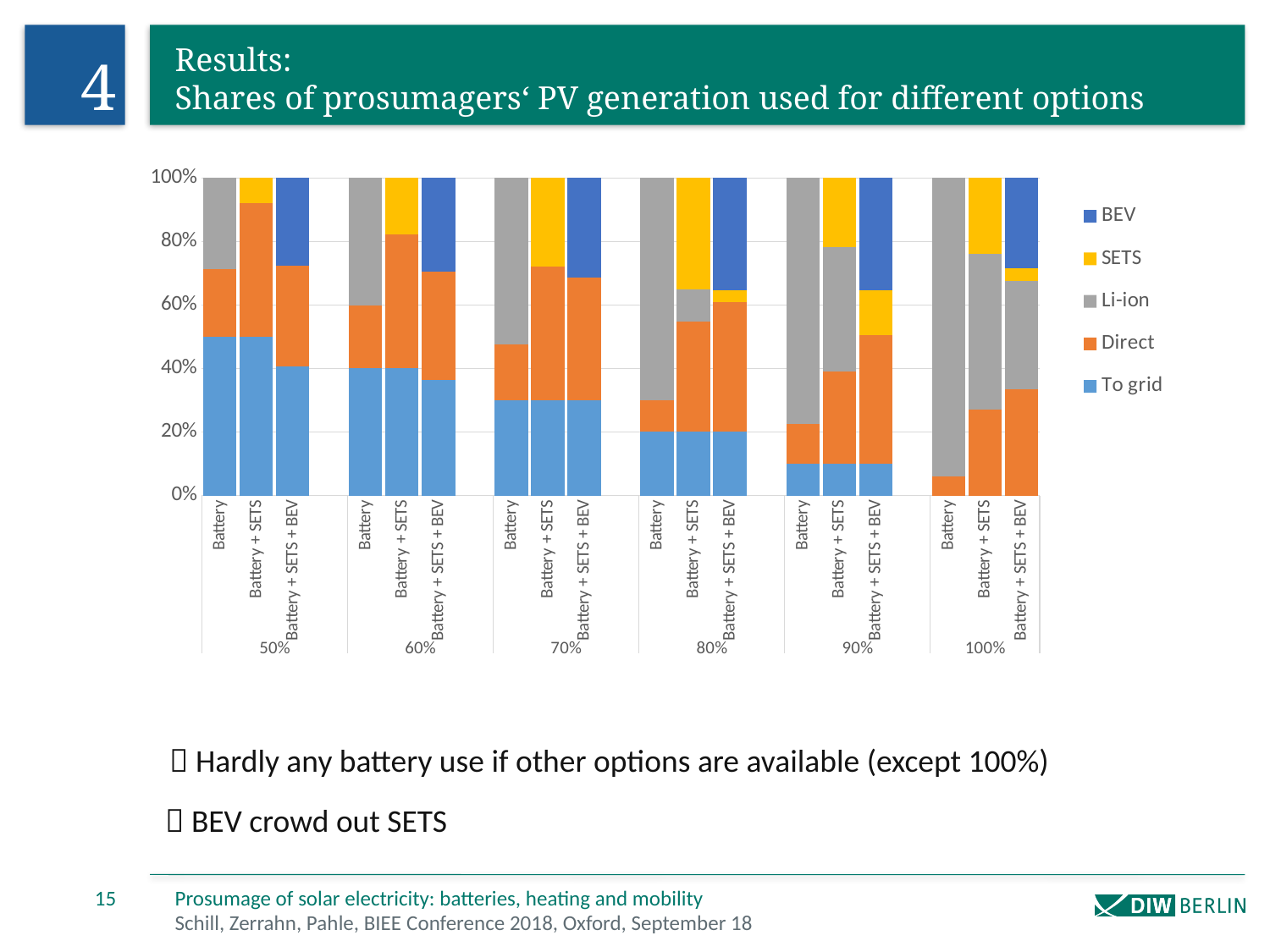
What does each stacked bar total? 100% How many series does the legend list? 5 Looking at the Battery bars, does the 'To grid' share rise or fall as the group moves from 50% to 100%? Fall Which has the larger 'To grid' share: the Battery bar in the 50% group or the Battery bar in the 100% group? Battery bar in the 50% group Is the 'To grid' share for the Battery bar in the 90% group greater or less than 20%? less Is the 'To grid' share for the Battery bar in the 50% group greater or less than 40%? greater What kind of chart is shown on the slide? Stacked bar chart How many self-consumption share groups (50% to 100%) are shown on the x axis? 6 Is the 'Li-ion' share for the Battery bar in the 100% group greater or less than 80%? greater Which series are listed in the chart legend? BEV, SETS, Li-ion, Direct, To grid How many bars are plotted in the chart? 18